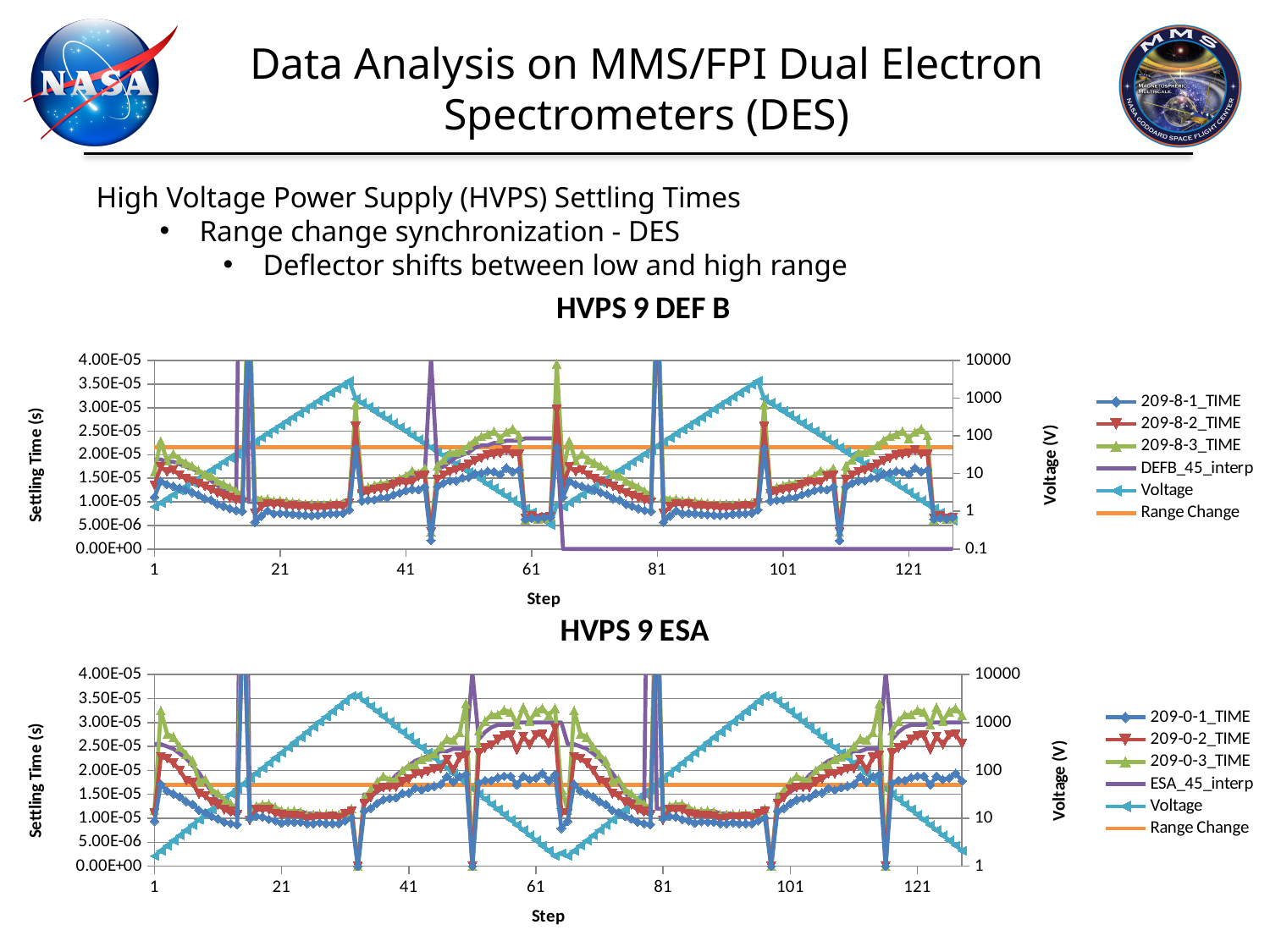
In the HVPS 9 ESA chart, does the Voltage series rise or fall between step 33 and step 65? fall In the HVPS 9 DEF B chart, what is the label of the left vertical axis? Settling Time (s) How many series does the legend of the HVPS 9 ESA chart list? 6 In the HVPS 9 DEF B chart, is the Range Change line greater or less than 10 on the Voltage (V) axis? greater In the HVPS 9 ESA chart, is the peak of the Voltage series near step 33 greater or less than 1000 on the Voltage (V) axis? greater What kind of chart is the HVPS 9 ESA chart? line chart In the HVPS 9 DEF B chart, is the Range Change line greater or less than 100 on the Voltage (V) axis? less In the HVPS 9 ESA chart, what is the label of the right vertical axis? Voltage (V) In the HVPS 9 DEF B chart, does the Voltage series rise or fall between step 1 and step 33? rise How many series does the legend of the HVPS 9 DEF B chart list? 6 What kind of chart is the HVPS 9 DEF B chart? line chart